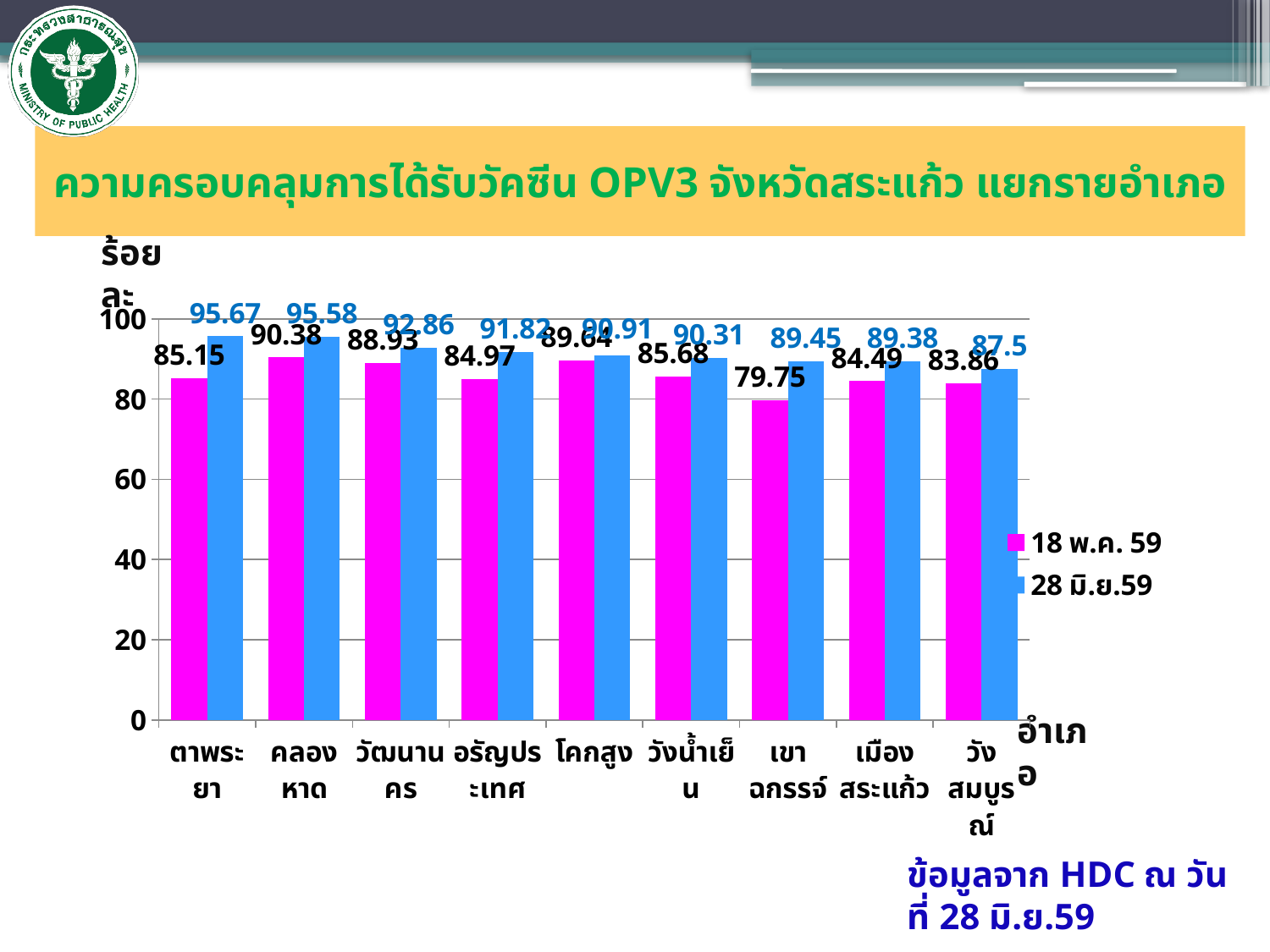
What is the difference between the 28 มิ.ย.59 and 18 พ.ค. 59 values for ตาพระยา? 10.52 Is the 18 พ.ค. 59 value for เขาฉกรรจ์ greater or less than 80? less Which district has the lowest value in the 28 มิ.ย.59 series? วังสมบูรณ์ Which is larger for โคกสูง: the 18 พ.ค. 59 value or the 28 มิ.ย.59 value? 28 มิ.ย.59 What is the value for ตาพระยา in the 18 พ.ค. 59 series? 85.15 What is the value for วังสมบูรณ์ in the 28 มิ.ย.59 series? 87.5 Do the 28 มิ.ย.59 values rise or fall from left to right along the x axis? fall Which district has the highest value in the 18 พ.ค. 59 series? คลองหาด How many districts are shown on the x axis? 9 What is the value for เขาฉกรรจ์ in the 28 มิ.ย.59 series? 89.45 How many series does the legend list? 2 Which district has the lowest value in the 18 พ.ค. 59 series? เขาฉกรรจ์